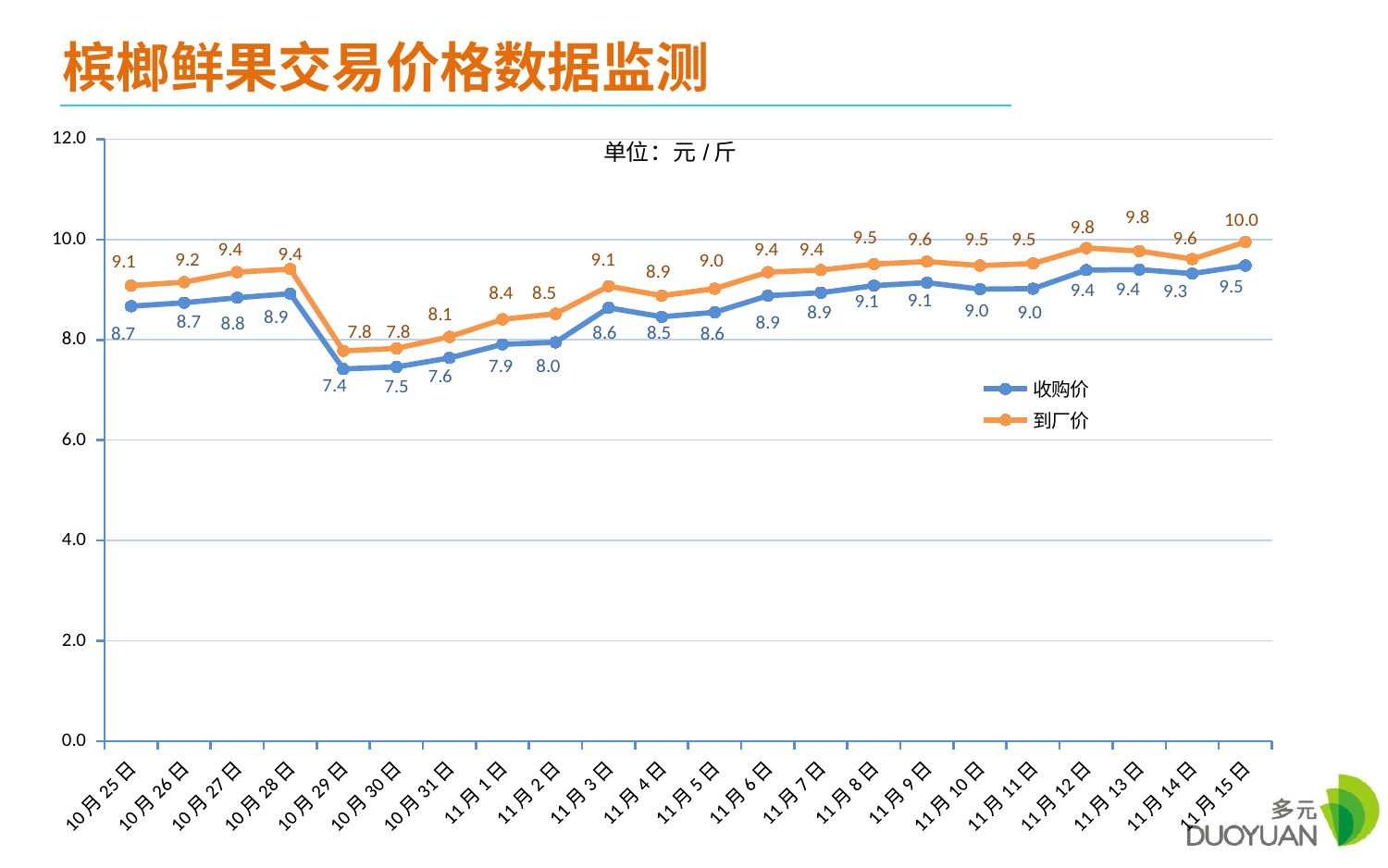
On which date is the 收购价 lowest? 10月29日 What type of chart is shown on the slide? line chart Which is larger on 10月28日, the 收购价 or the 到厂价? 到厂价 On which date is the 到厂价 highest? 11月15日 Does the 收购价 rise or fall from 10月28日 to 10月29日? fall How many dates are plotted along the x axis? 22 What is the difference between 到厂价 and 收购价 on 11月15日? 0.5 What unit is stated at the top of the chart? 元 / 斤 What is the 收购价 value on 10月29日? 7.4 How many series does the legend list? 2 What is the 到厂价 value on 11月15日? 10.0 What is the 到厂价 value on 11月3日? 9.1